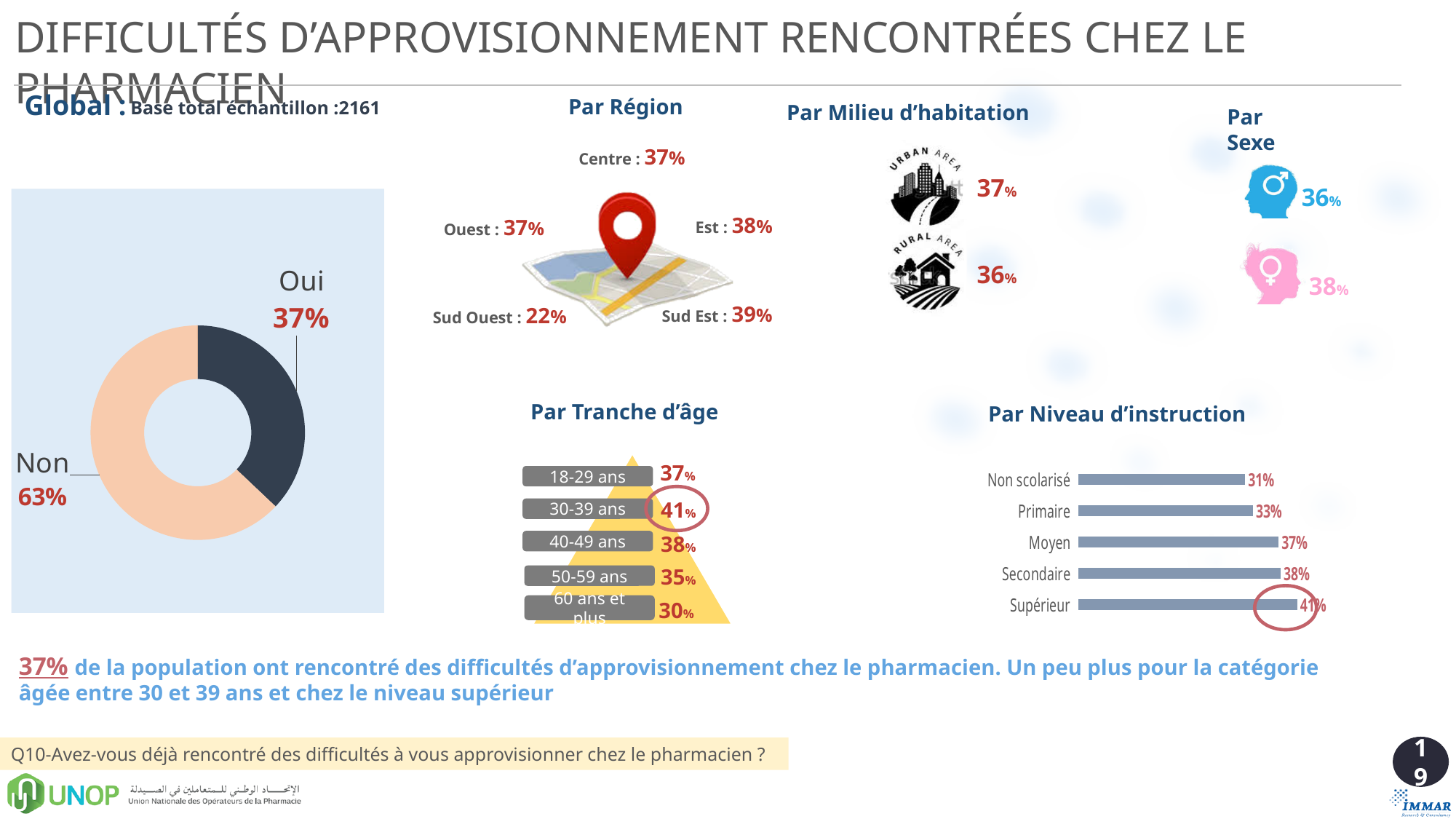
In the Global donut chart, what percentage answered "Non"? 63% In the Global donut chart, what percentage answered "Oui"? 37% In the "Par Niveau d'instruction" chart, which category has the highest value? Supérieur What kind of chart is the Global chart on the left of the slide? Donut (pie) chart In the Global donut chart, what is the difference between the "Non" and "Oui" shares? 26% In the "Par Niveau d'instruction" chart, what is the value for "Supérieur"? 41% In the "Par Niveau d'instruction" chart, do the values rise or fall from "Non scolarisé" to "Supérieur"? Rise In the Global donut chart, which slice is larger, "Oui" or "Non"? Non In the "Par Niveau d'instruction" chart, what is the value for "Non scolarisé"? 31% How many categories are shown in the "Par Niveau d'instruction" chart? 5 In the "Par Niveau d'instruction" chart, which category has the lowest value? Non scolarisé In the "Par Niveau d'instruction" chart, what is the difference between "Secondaire" and "Primaire"? 5%